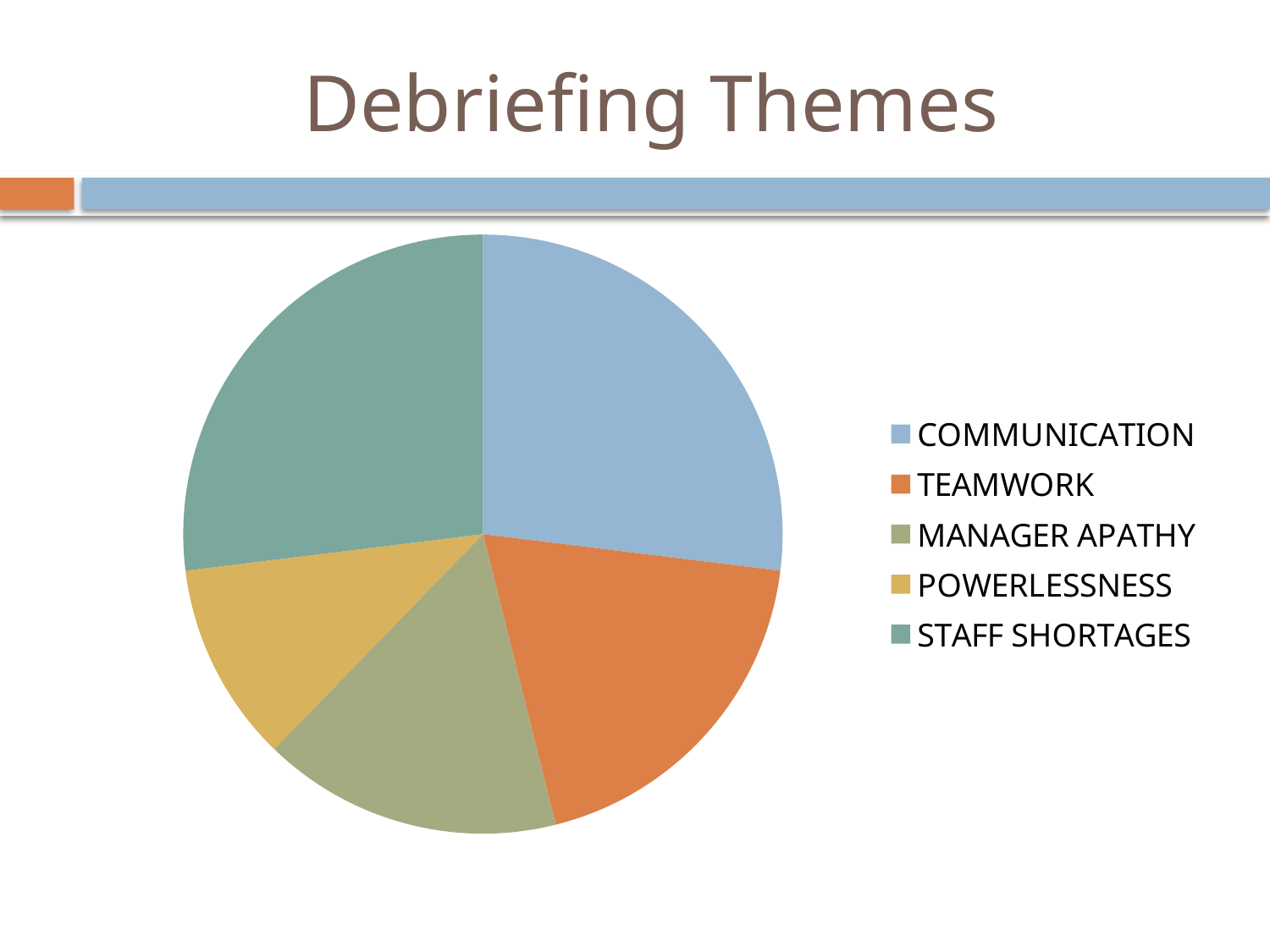
Which slice is larger, STAFF SHORTAGES or MANAGER APATHY? STAFF SHORTAGES Which colour represents TEAMWORK in the pie chart? Orange Which slice is larger, COMMUNICATION or POWERLESSNESS? COMMUNICATION Which category has the smallest slice in the pie chart? POWERLESSNESS Which category is listed first in the legend of the pie chart? COMMUNICATION Which slice is larger, TEAMWORK or POWERLESSNESS? TEAMWORK What is the title of the slide containing the pie chart? Debriefing Themes What kind of chart is shown on the slide? Pie chart How many slices does the pie chart have? 5 How many entries does the legend of the pie chart list? 5